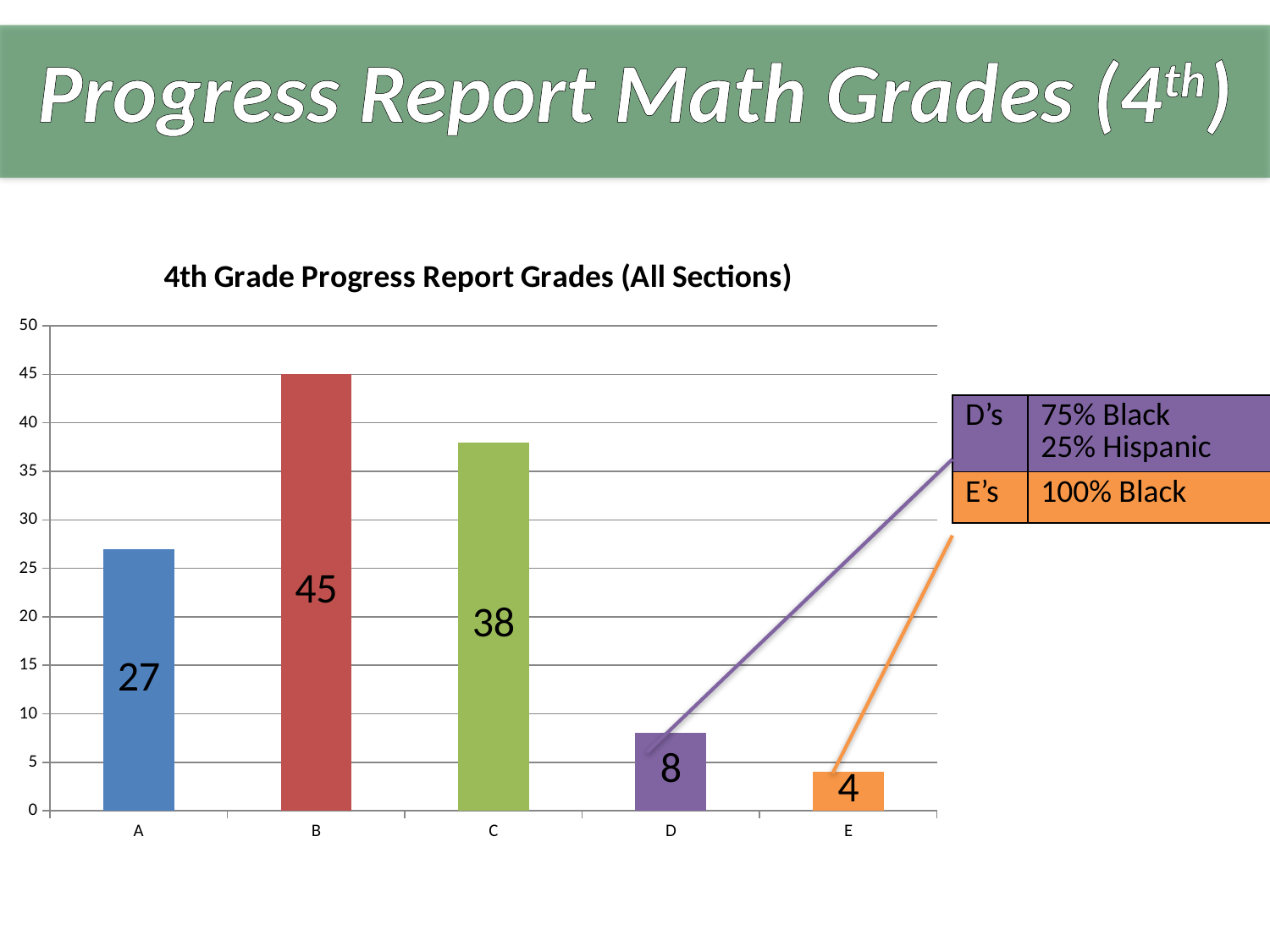
What is the difference between the values for D and E? 4 What is the title of the chart? 4th Grade Progress Report Grades (All Sections) What is the difference between the values for B and C? 7 What kind of chart is shown on the slide? bar chart What is the value for grade C? 38 Which grade category has the highest value? B How many grade categories are shown on the x axis? 5 What is the value for grade E? 4 What is the value for grade A? 27 Which grade category has the lowest value? E Which is larger, the value for A or the value for C? C Is the value for B greater or less than 40? greater